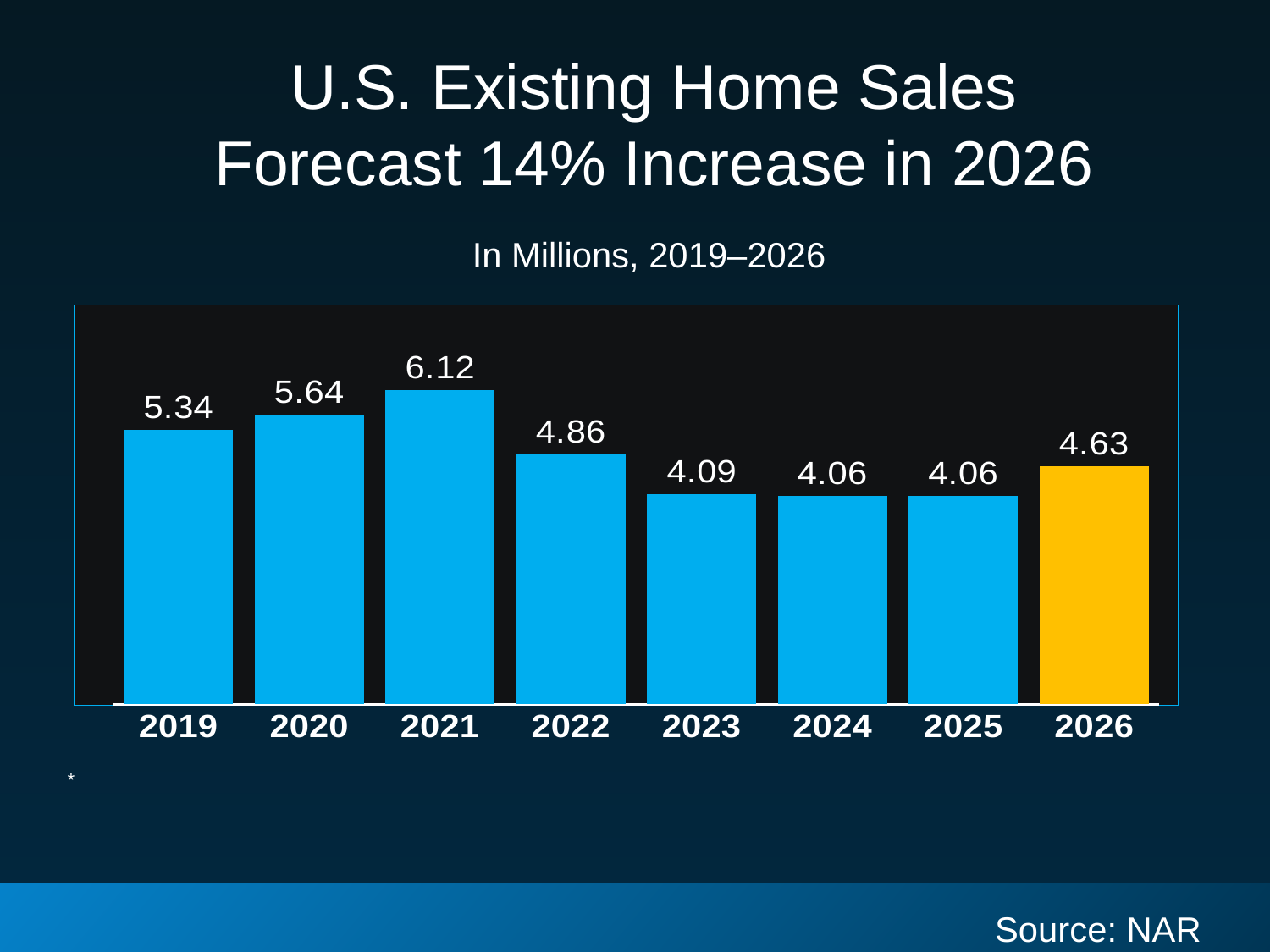
Which year has the highest value? 2021 What is the value for 2026? 4.63 What is the title of the chart? U.S. Existing Home Sales Forecast 14% Increase in 2026 What kind of chart is this? bar chart What is the difference between the 2021 value and the 2022 value? 1.26 What is the value for 2021? 6.12 Which is larger, the value for 2020 or the value for 2022? 2020 What is the difference between the 2026 value and the 2025 value? 0.57 Which year's bar is coloured differently from the others? 2026 How many years are shown on the x axis? 8 Do the values rise or fall from 2021 to 2024? fall What is the value for 2019? 5.34